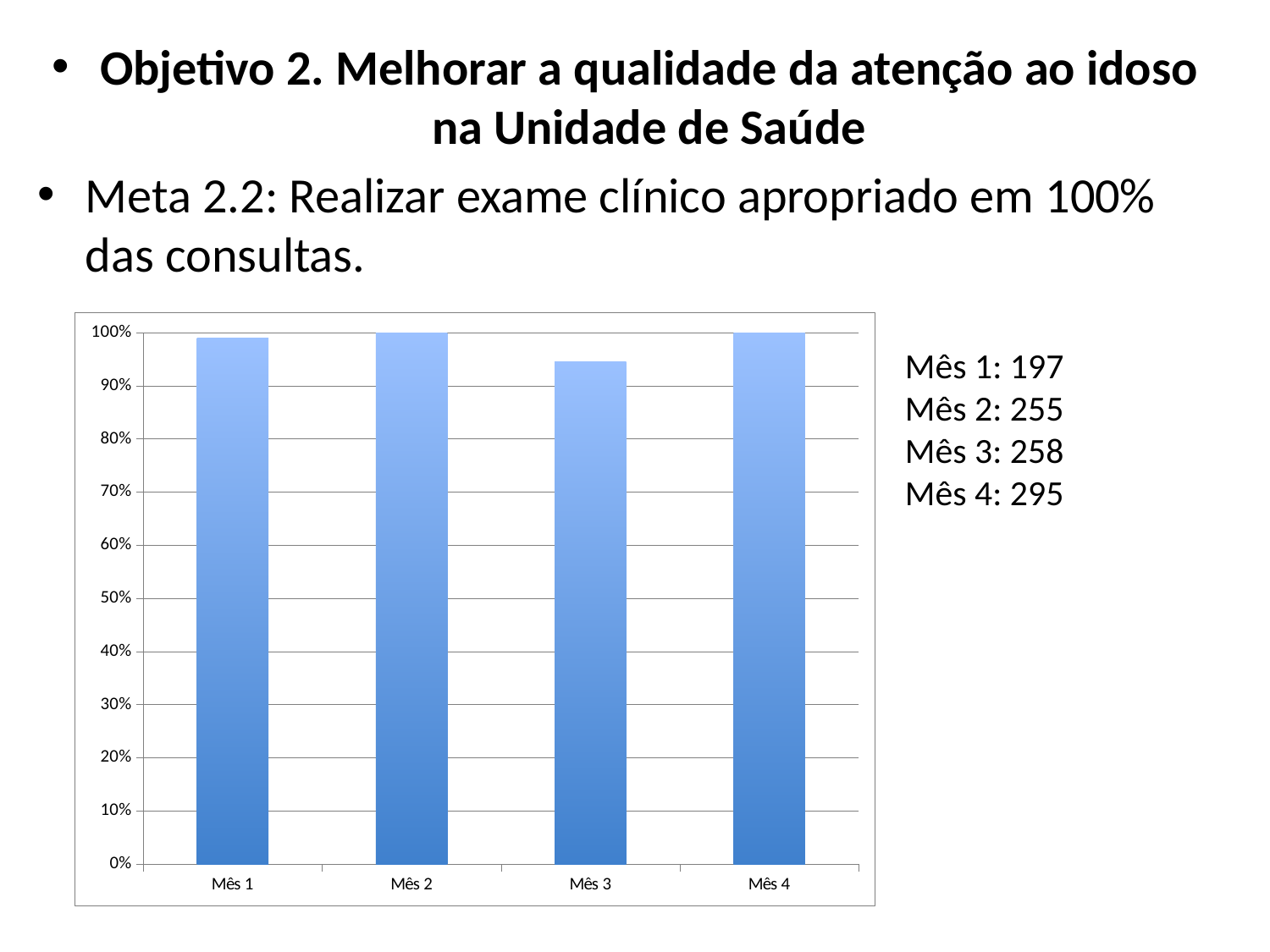
What kind of chart is shown on the slide? bar chart Is the value for Mês 3 greater or less than 90%? greater What is the value for Mês 2 in the chart? 100% Is the value for Mês 1 greater or less than 90%? greater Which is larger in the chart, the value for Mês 1 or the value for Mês 3? Mês 1 Is the value for Mês 3 greater or less than 100%? less Does the value rise or fall from Mês 3 to Mês 4 in the chart? rise Which month has the lowest value in the chart? Mês 3 What is the highest value shown on the y axis of the chart? 100% What is the value for Mês 4 in the chart? 100% Which is larger in the chart, the value for Mês 2 or the value for Mês 3? Mês 2 How many categories (months) are shown on the x axis of the chart? 4